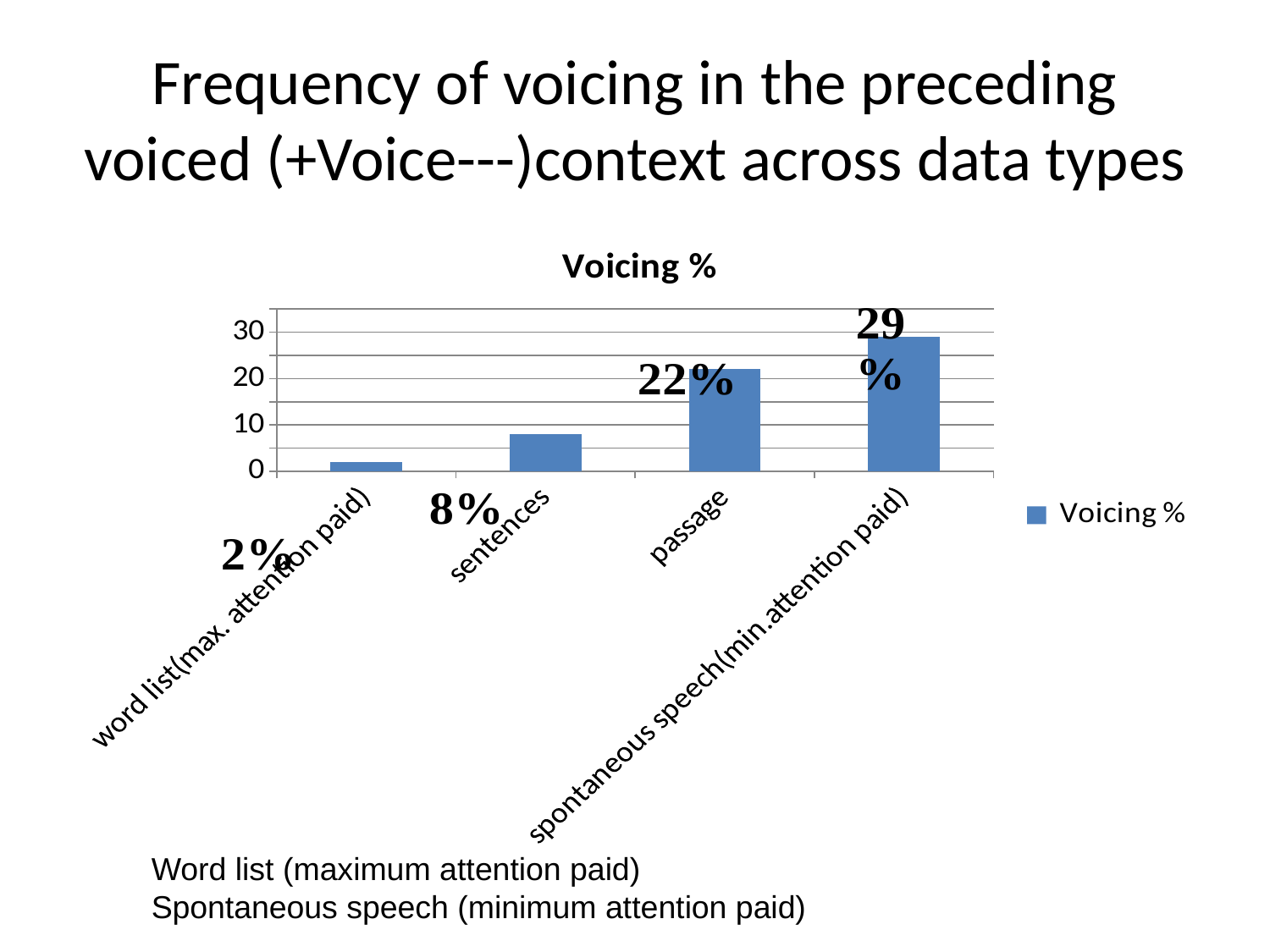
What is the Voicing % value for passage? 22% How many series does the legend list? 1 What kind of chart is shown on the slide? bar chart Which has a higher Voicing %, sentences or passage? passage Do the Voicing % values rise or fall from word list to spontaneous speech along the x axis? rise Is the Voicing % for passage greater or less than 20? greater Which category has the lowest Voicing %? word list(max. attention paid) What is the difference in Voicing % between spontaneous speech and passage? 7% What is the Voicing % value for sentences? 8% What is the Voicing % value for spontaneous speech (min. attention paid)? 29% How many categories are shown on the x axis of the chart? 4 Which category has the highest Voicing %? spontaneous speech(min.attention paid)